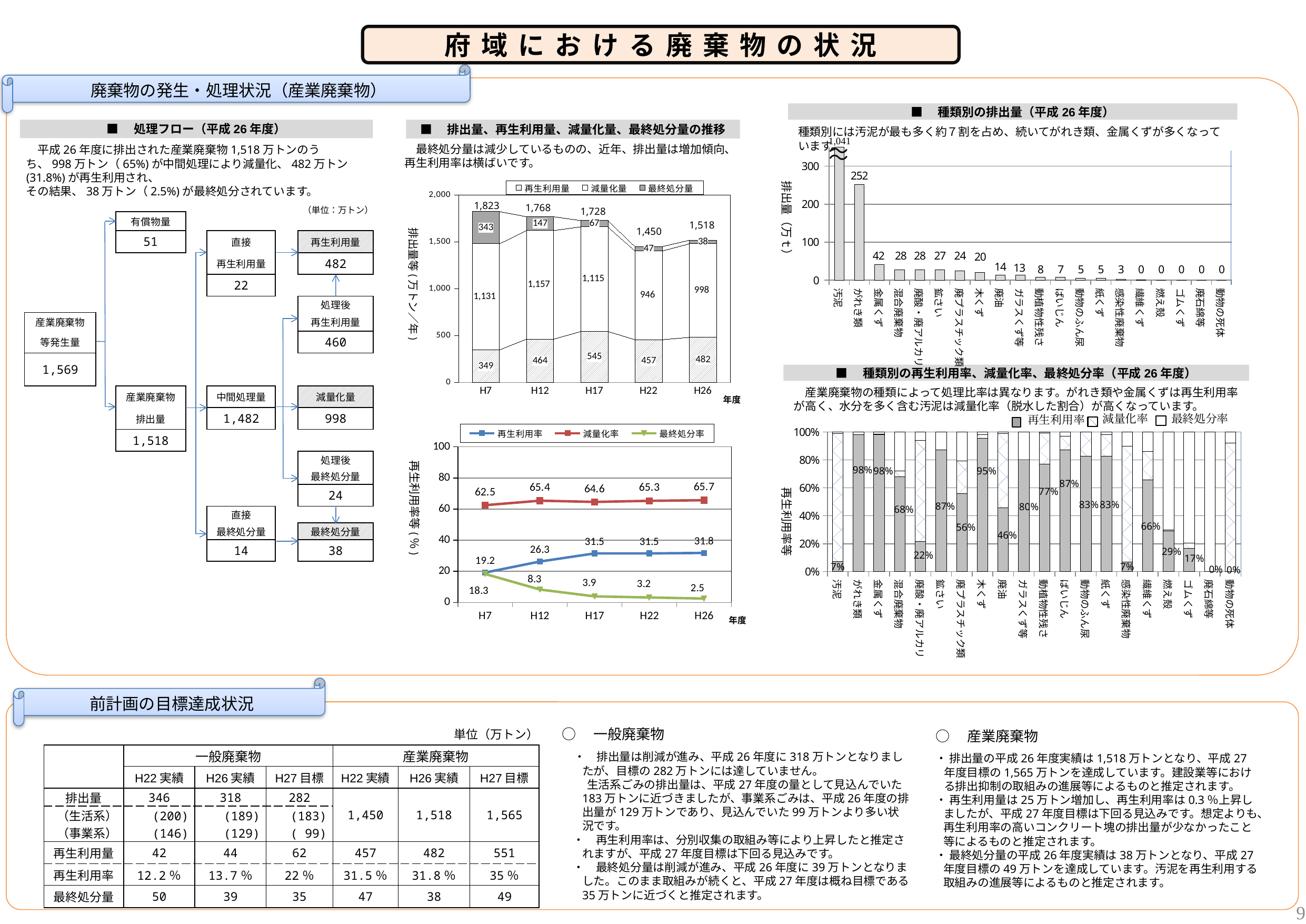
In the chart titled 種類別の再生利用率、減量化率、最終処分率（平成26年度）, what is the 再生利用率 for 廃プラスチック類? 56% In the line chart showing 再生利用率, 減量化率 and 最終処分率, how many series does the legend list? 3 In the chart titled 種類別の排出量（平成26年度）, which category has the highest value? 汚泥 In the chart titled 種類別の排出量（平成26年度）, how many categories are shown on the x axis? 20 In the chart titled 排出量、再生利用量、減量化量、最終処分量の推移, which year has the highest total 排出量? H7 In the line chart showing 再生利用率, 減量化率 and 最終処分率, what is the 再生利用率 value for H12? 26.3 In the chart titled 排出量、再生利用量、減量化量、最終処分量の推移, what is the total 排出量 for H26? 1,518 In the chart titled 種類別の再生利用率、減量化率、最終処分率（平成26年度）, which is larger, the 再生利用率 for 木くず or for 廃油? 木くず In the line chart showing 再生利用率, 減量化率 and 最終処分率, does the 最終処分率 rise or fall from H7 to H26? fall In the chart titled 排出量、再生利用量、減量化量、最終処分量の推移, what is the 最終処分量 value for H7? 343 In the chart titled 排出量、再生利用量、減量化量、最終処分量の推移, what is the difference between the 再生利用量 for H17 and for H7? 196 In the chart titled 種類別の排出量（平成26年度）, what is the value for がれき類? 252